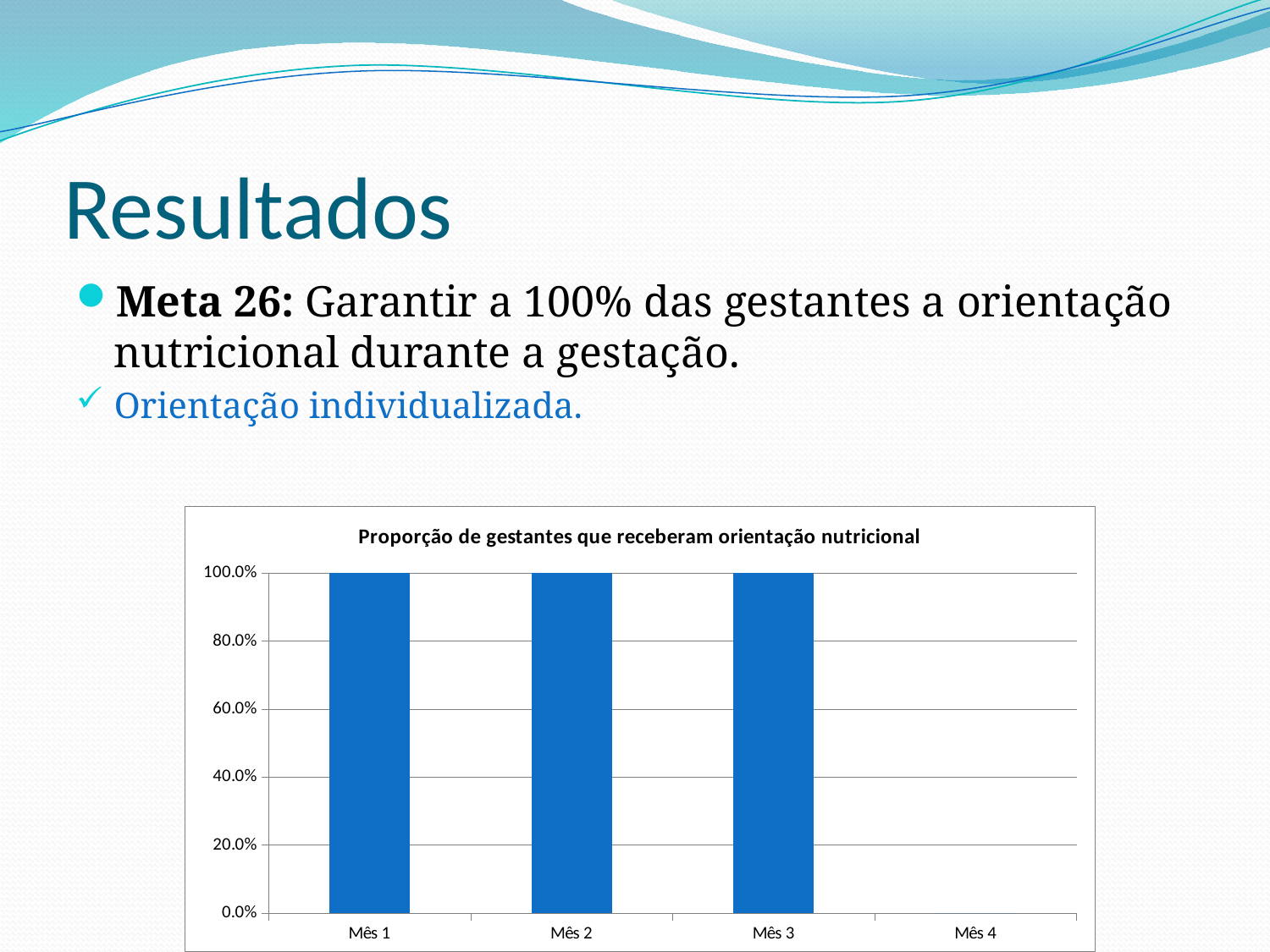
Is the value for Mês 1 greater or less than 80.0%? greater What is the value for Mês 1? 100.0% What is the value for Mês 2? 100.0% Which is larger, the value for Mês 2 or the value for Mês 4? Mês 2 How many categories are shown on the x axis of the chart? 4 Is the value for Mês 3 greater or less than 60.0%? greater What kind of chart is shown on the slide? bar chart What is the difference between the values for Mês 1 and Mês 3? 0.0% What is the title of the chart? Proporção de gestantes que receberam orientação nutricional What is the highest value shown on the y axis of the chart? 100.0% Which category has no visible bar in the chart? Mês 4 What is the value for Mês 3? 100.0%